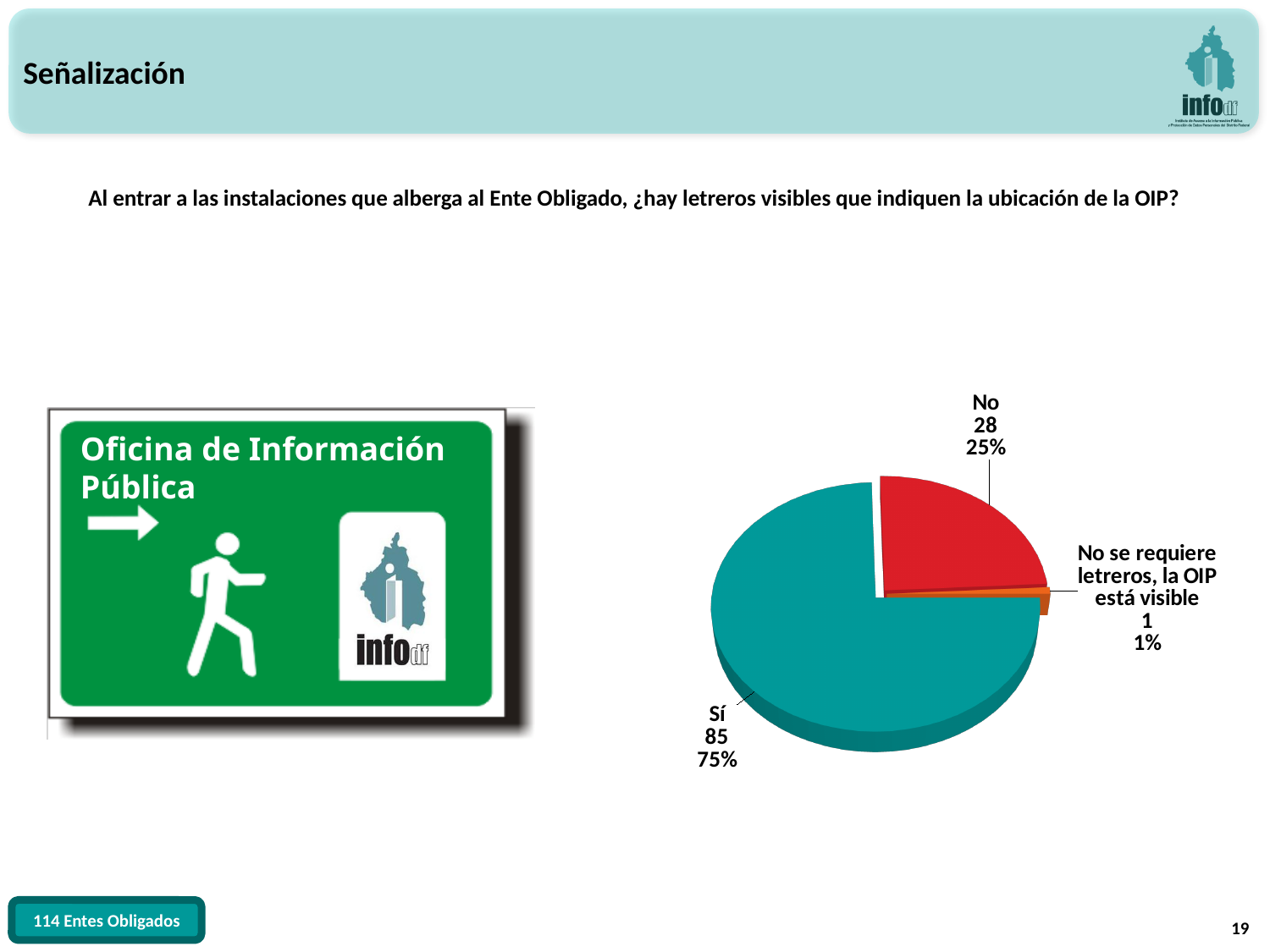
Which category has the largest slice? Sí How many slices does the pie chart have? 3 What percentage does the "No" slice represent? 25% Which is larger, the count for "No" or the count for "No se requiere letreros, la OIP está visible"? No What is the difference between the counts for "Sí" and "No"? 57 What kind of chart is shown on the slide? pie chart What is the count for the "No" slice? 28 What is the count for the "No se requiere letreros, la OIP está visible" slice? 1 What is the count for the "Sí" slice? 85 What colour is the "Sí" slice? teal What percentage does the "Sí" slice represent? 75% Which category has the smallest slice? No se requiere letreros, la OIP está visible